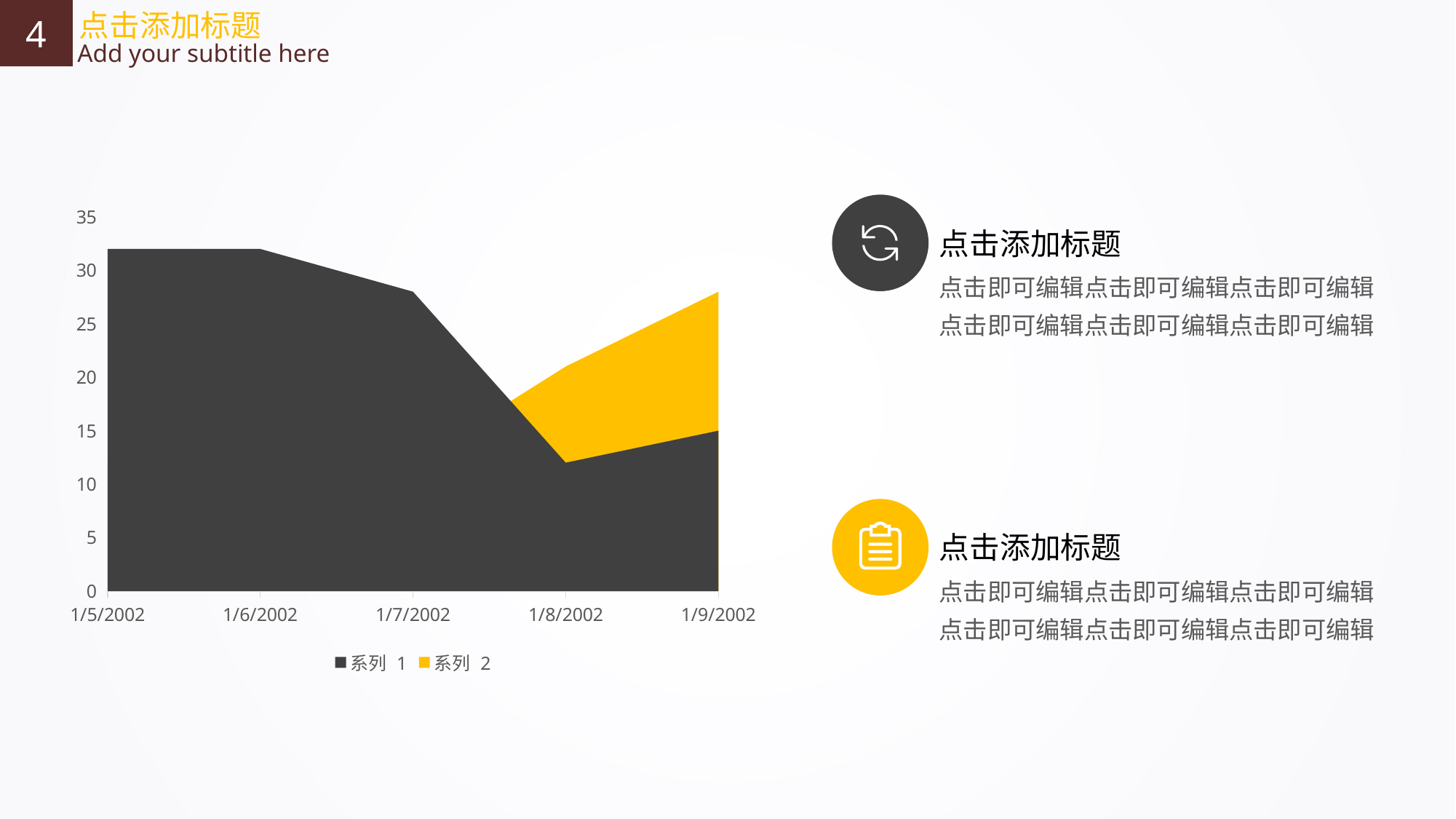
Is the value of 系列 1 at 1/5/2002 greater or less than 30? greater At 1/9/2002, which series has the higher value, 系列 1 or 系列 2? 系列 2 How many series does the chart legend list? 2 At which date does 系列 1 reach its lowest value? 1/8/2002 Is the value of 系列 1 at 1/8/2002 greater or less than 15? less How many dates are shown on the x axis of the chart? 5 Is the value of 系列 2 at 1/9/2002 greater or less than 25? greater What kind of chart is shown on the slide? Area chart Does the value of 系列 1 rise or fall from 1/6/2002 to 1/8/2002? Fall What colour represents 系列 2 in the chart? Yellow